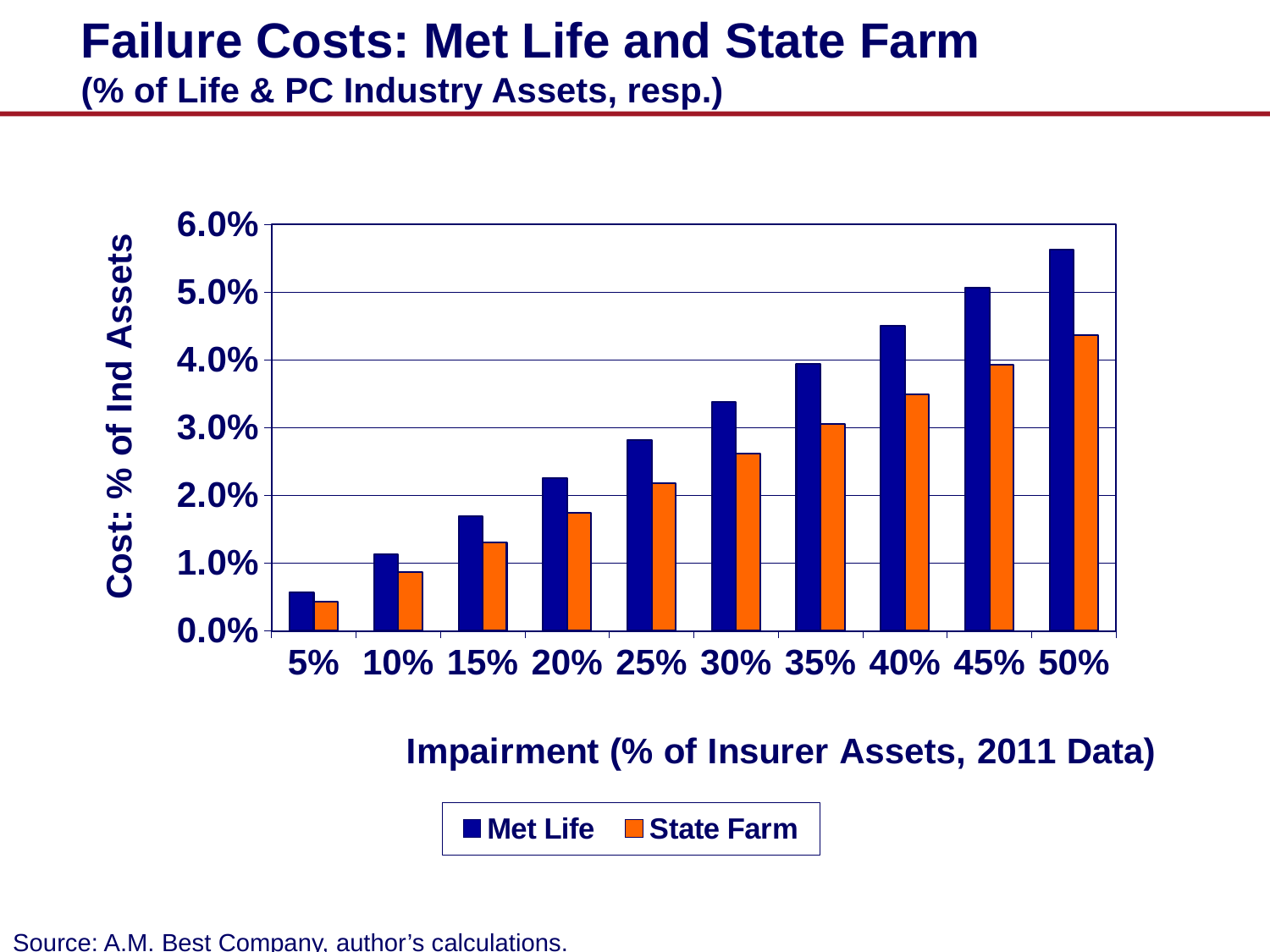
Which series has the highest bar at the 50% impairment level? Met Life Which is larger at 35% impairment, the Met Life value or the State Farm value? Met Life How many series does the legend list? 2 Is the Met Life value at 40% impairment greater or less than 4.0%? greater What type of chart is shown on the slide? bar chart How many impairment categories are shown on the x axis? 10 At which impairment level is the Met Life bar lowest? 5% Is the State Farm value at 10% impairment greater or less than 1.0%? less Is the Met Life value at 50% impairment greater or less than 5.0%? greater Do the Met Life values rise or fall as impairment increases from 5% to 50%? rise